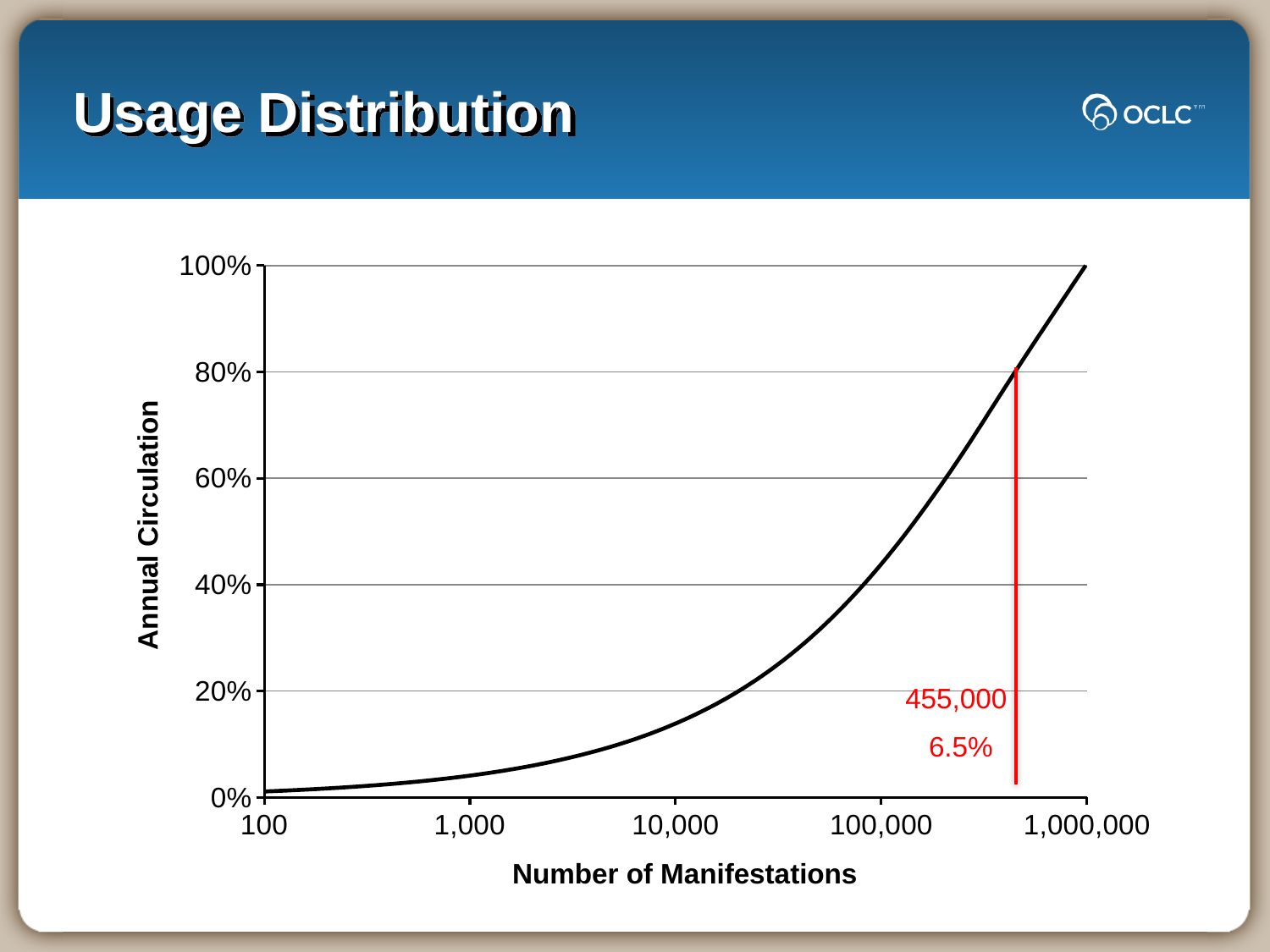
Is the Annual Circulation at 1,000 manifestations greater or less than 20%? less What Annual Circulation value does the curve reach at 1,000,000 manifestations? 100% What is the title of the slide containing the chart? Usage Distribution How many labelled tick marks are on the x axis? 5 What number of manifestations is marked by the red vertical line? 455,000 Does the Annual Circulation curve rise or fall as the Number of Manifestations increases? rise What percentage is printed in red next to the 455,000 marker? 6.5% What is the label of the x axis? Number of Manifestations Is the Annual Circulation at 100 manifestations greater or less than 20%? less Is the Annual Circulation at 10,000 manifestations greater or less than 20%? less What kind of chart is shown on the slide? line chart